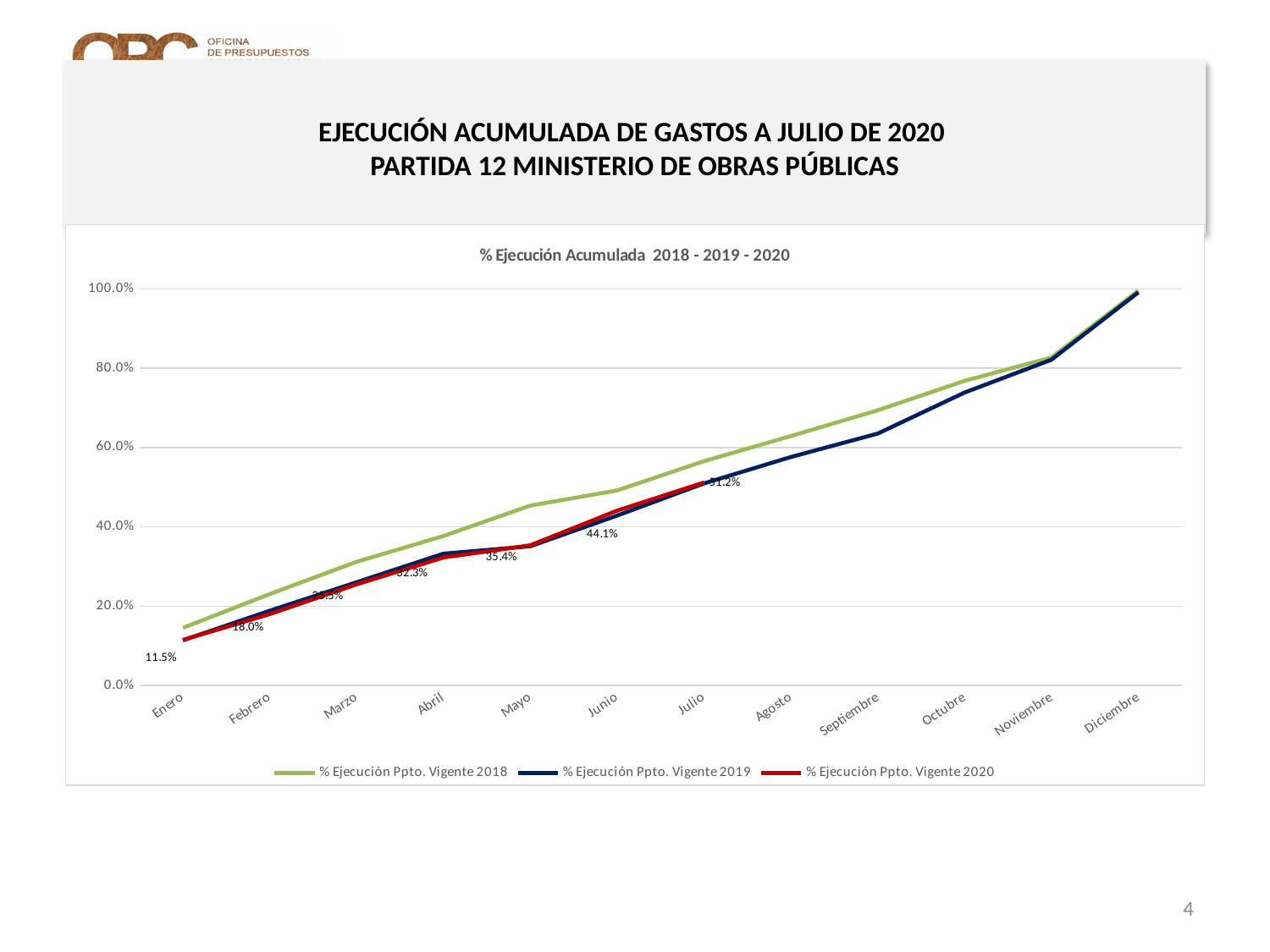
What is the value for % Ejecución Ppto. Vigente 2020 in Abril? 32.3% How many months are shown along the x axis? 12 What is the value for % Ejecución Ppto. Vigente 2020 in Julio? 51.2% How many series does the legend list? 3 What is the difference between the 2020 values for Junio and Mayo? 8.7% What kind of chart is shown on the slide? Line chart What is the difference between the 2020 values for Julio and Enero? 39.7% What is the value for % Ejecución Ppto. Vigente 2020 in Enero? 11.5% In Septiembre, which series is higher: % Ejecución Ppto. Vigente 2018 or % Ejecución Ppto. Vigente 2019? % Ejecución Ppto. Vigente 2018 What is the value for % Ejecución Ppto. Vigente 2020 in Mayo? 35.4% Is the value for % Ejecución Ppto. Vigente 2018 in Diciembre greater or less than 80.0%? greater Do the values for % Ejecución Ppto. Vigente 2020 rise or fall from Enero to Julio? Rise